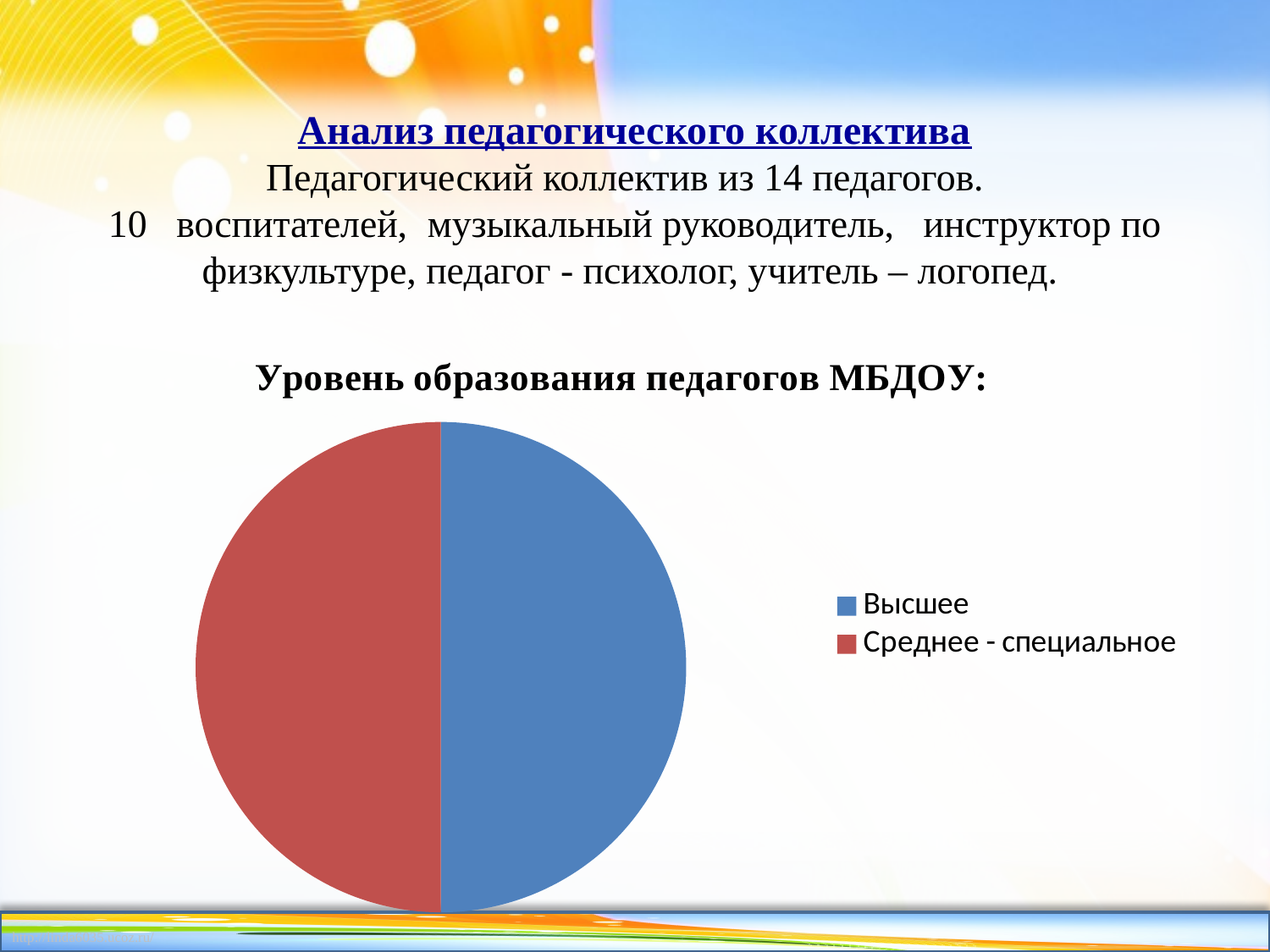
How many entries does the legend of the pie chart list? 2 How many slices does the pie chart have? 2 Which category is represented by the red slice of the pie chart? Среднее - специальное What kind of chart is shown on the slide? pie chart What is the title of the pie chart? Уровень образования педагогов МБДОУ: Which legend entry is shown in blue on the pie chart? Высшее